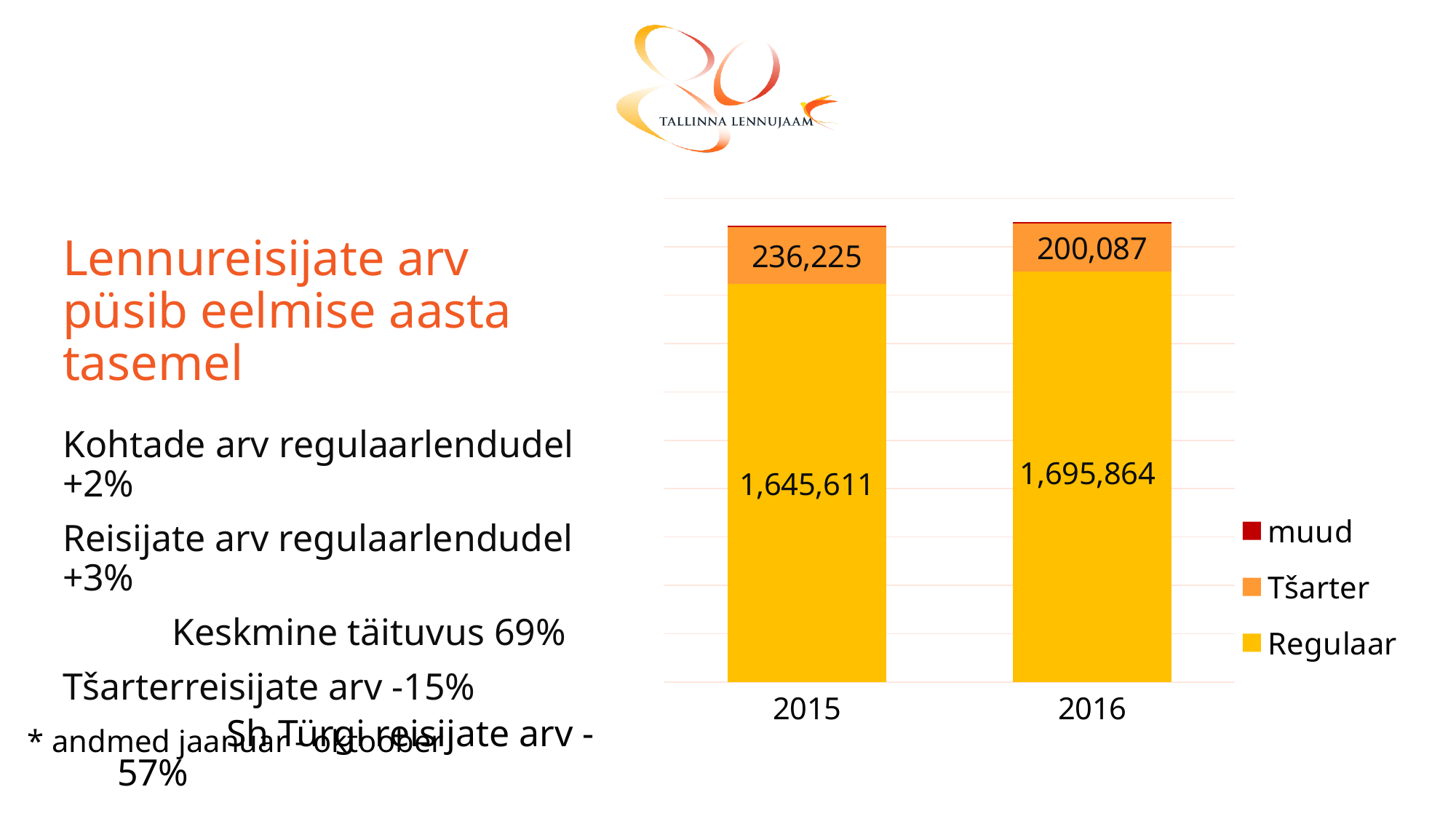
What is the Regulaar value for 2015? 1,645,611 What is the difference between the Tšarter values for 2015 and 2016? 36,138 What is the Tšarter value for 2015? 236,225 Which year has the higher Regulaar value, 2015 or 2016? 2016 How many years are shown on the x axis of the chart? 2 What kind of chart is shown on the slide? Stacked bar chart Which year has the lower Tšarter value? 2016 What is the Tšarter value for 2016? 200,087 How many series does the legend list? 3 What is the Regulaar value for 2016? 1,695,864 By how much did the Regulaar value increase from 2015 to 2016? 50,253 Does the Tšarter value rise or fall from 2015 to 2016? Fall